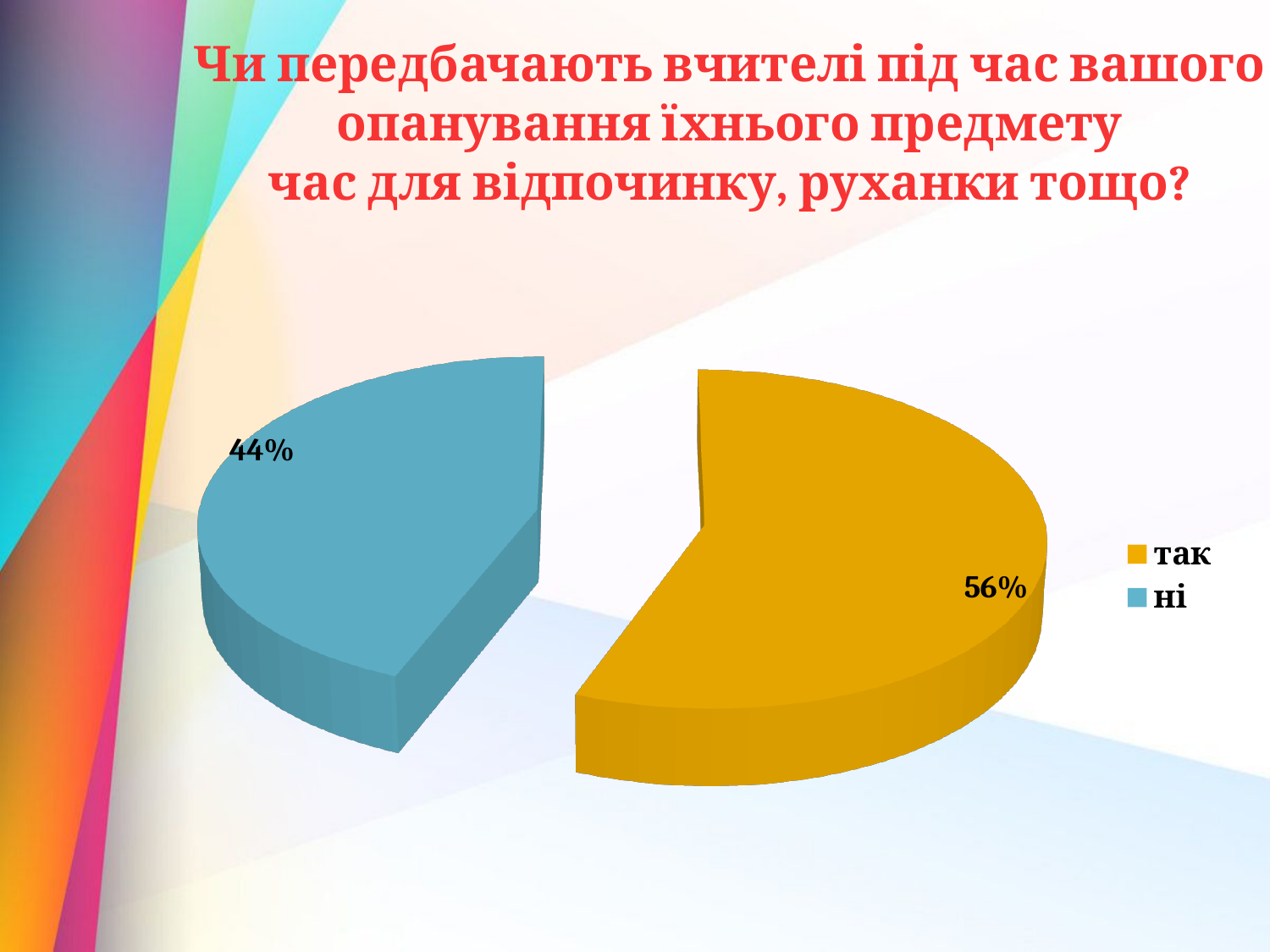
What kind of chart is shown on the slide? pie chart What colour is the "так" slice? yellow/orange How many entries does the legend list? 2 How many slices does the pie chart have? 2 Which category has the smallest slice of the pie? ні Which category has the largest slice of the pie? так What is the difference in percentage points between the "так" and "ні" slices? 12 What share of the pie is labelled "ні"? 44% What share of the pie is labelled "так"? 56% What colour is the "ні" slice? blue Which slice is larger, "так" or "ні"? так